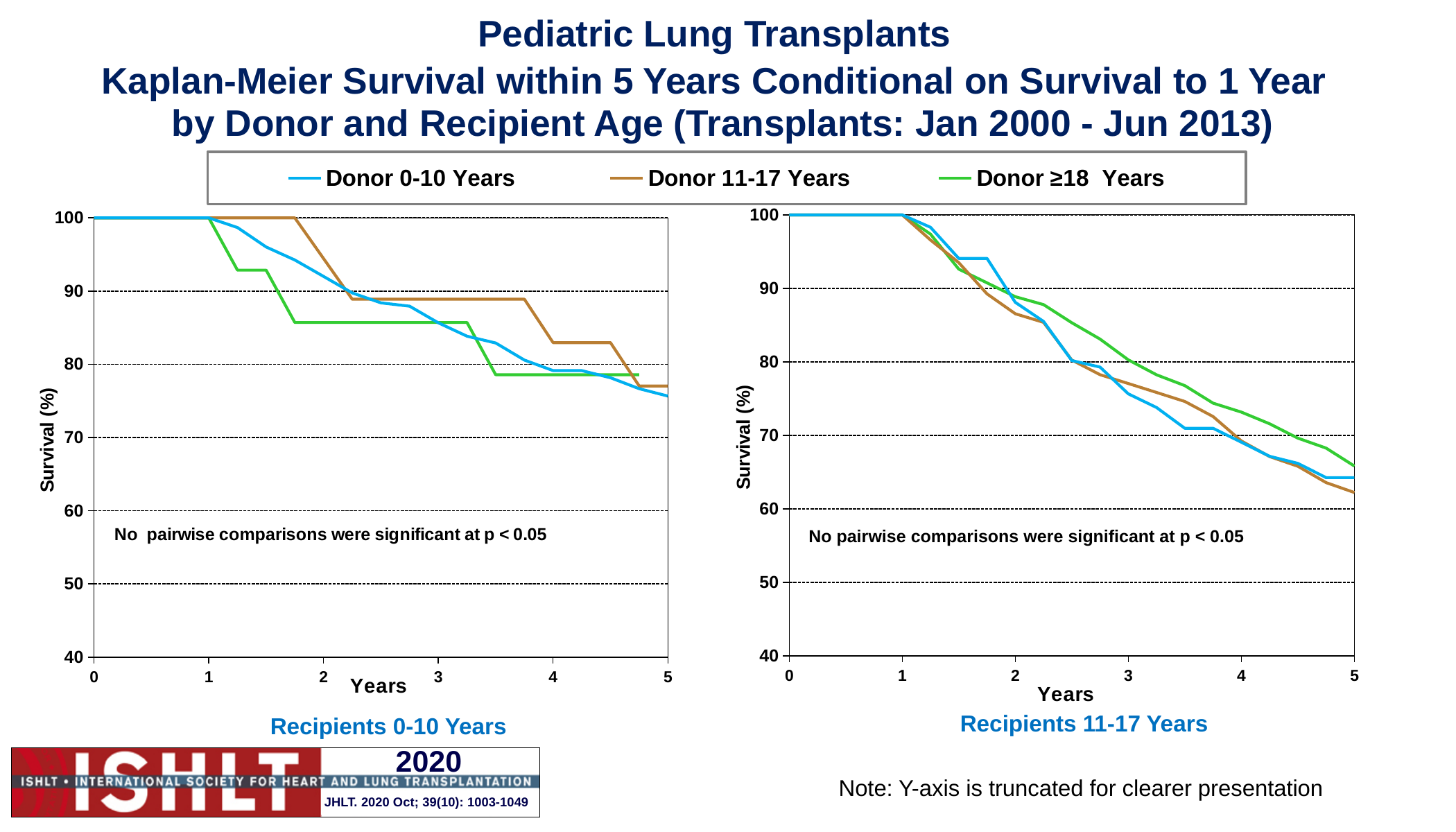
In the right chart (Recipients 11-17 Years), at year 5, which is higher: Donor ≥18 Years or Donor 11-17 Years? Donor ≥18 Years How many series does the legend list? 3 In the right chart (Recipients 11-17 Years), is the value for Donor 11-17 Years at year 5 greater or less than 60? greater What is the y-axis label on the charts? Survival (%) What kind of chart is the left chart (Recipients 0-10 Years)? line chart In the right chart (Recipients 11-17 Years), is the value for Donor 0-10 Years at year 5 greater or less than 70? less In the left chart (Recipients 0-10 Years), what is the survival value for Donor 0-10 Years at year 0? 100 In the right chart (Recipients 11-17 Years), do the survival values rise or fall as years increase? fall In the left chart (Recipients 0-10 Years), at year 2, which is higher: Donor 11-17 Years or Donor ≥18 Years? Donor 11-17 Years In the right chart (Recipients 11-17 Years), which series has the highest survival at year 5? Donor ≥18 Years In the left chart (Recipients 0-10 Years), is the value for Donor 0-10 Years at year 5 greater or less than 80? less